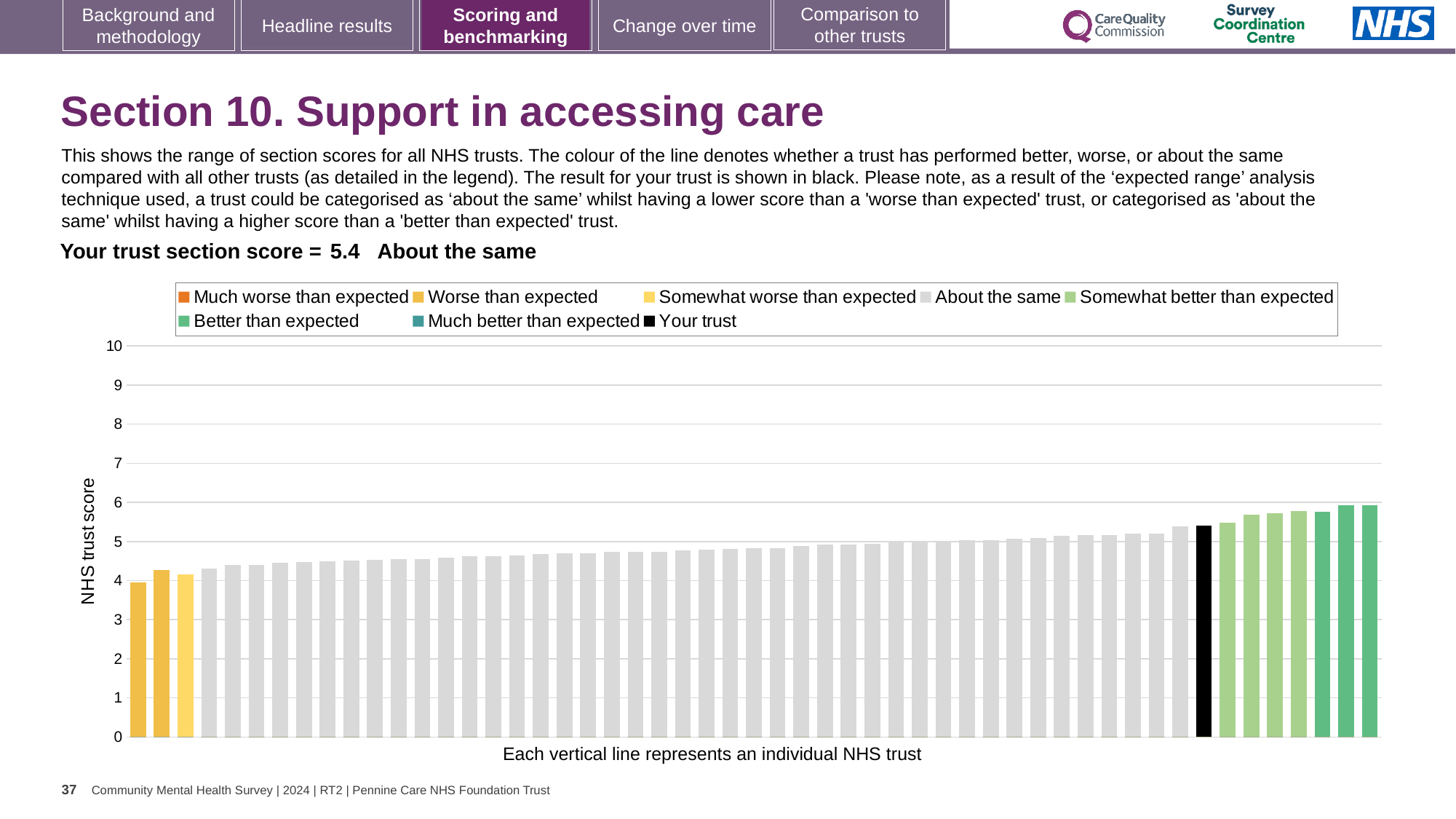
What colour does the legend use for 'Your trust'? black What kind of chart is shown on the slide? bar chart What is the highest value shown on the y axis? 10 Is the value of the tallest bar on the chart greater or less than 7? less Do the bar values rise or fall from left to right along the x axis? rise What is the title of the y axis? NHS trust score Which performance category is your trust placed in for this section? About the same What is the section score for your trust shown on the slide? 5.4 Is the value of the black bar (your trust) greater or less than 5? greater Is the value of the lowest bar on the chart greater or less than 3? greater How many entries does the chart legend list? 8